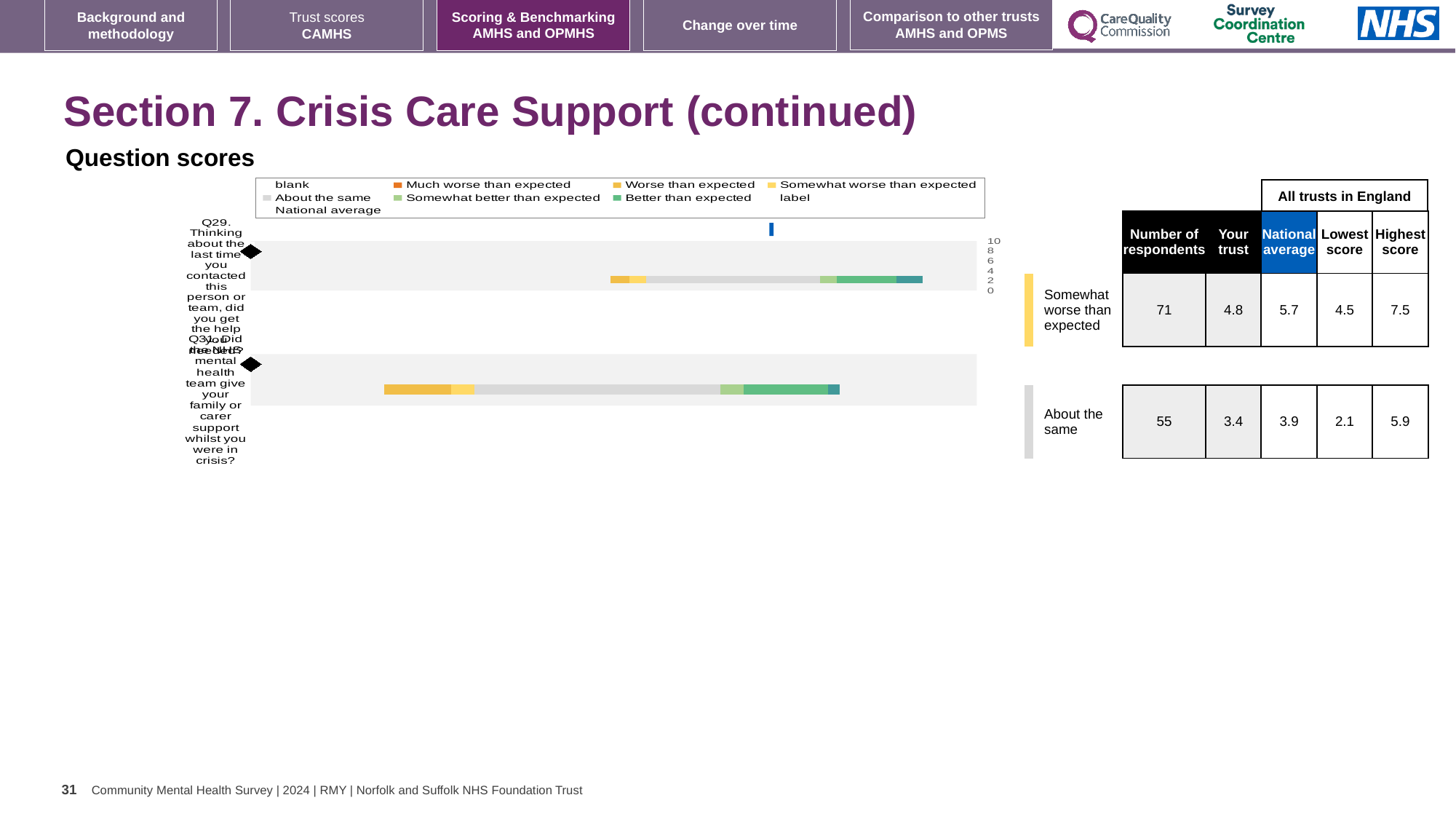
In the table beside the chart, what is the national average for the row labelled 'About the same'? 3.9 In the table beside the chart, how many respondents are there for the row labelled 'About the same'? 55 Which two question numbers are plotted in the chart? Q29 and Q31 In the table beside the chart, what is the number of respondents for the row labelled 'Somewhat worse than expected'? 71 In the table beside the chart, which row has the larger 'Your trust' score: 'Somewhat worse than expected' or 'About the same'? Somewhat worse than expected In the table beside the chart, what is the highest score for the row labelled 'About the same'? 5.9 How many questions (categories) are plotted in the chart? 2 What kind of chart is shown under 'Question scores'? bar chart In the table beside the chart, what is the difference between the highest score and the lowest score for the row labelled 'About the same'? 3.8 In the table beside the chart, what is the lowest score for the row labelled 'Somewhat worse than expected'? 4.5 Which legend entry is shown with a dark green colour? Better than expected In the table beside the chart, what is the 'Your trust' score for the row labelled 'Somewhat worse than expected'? 4.8